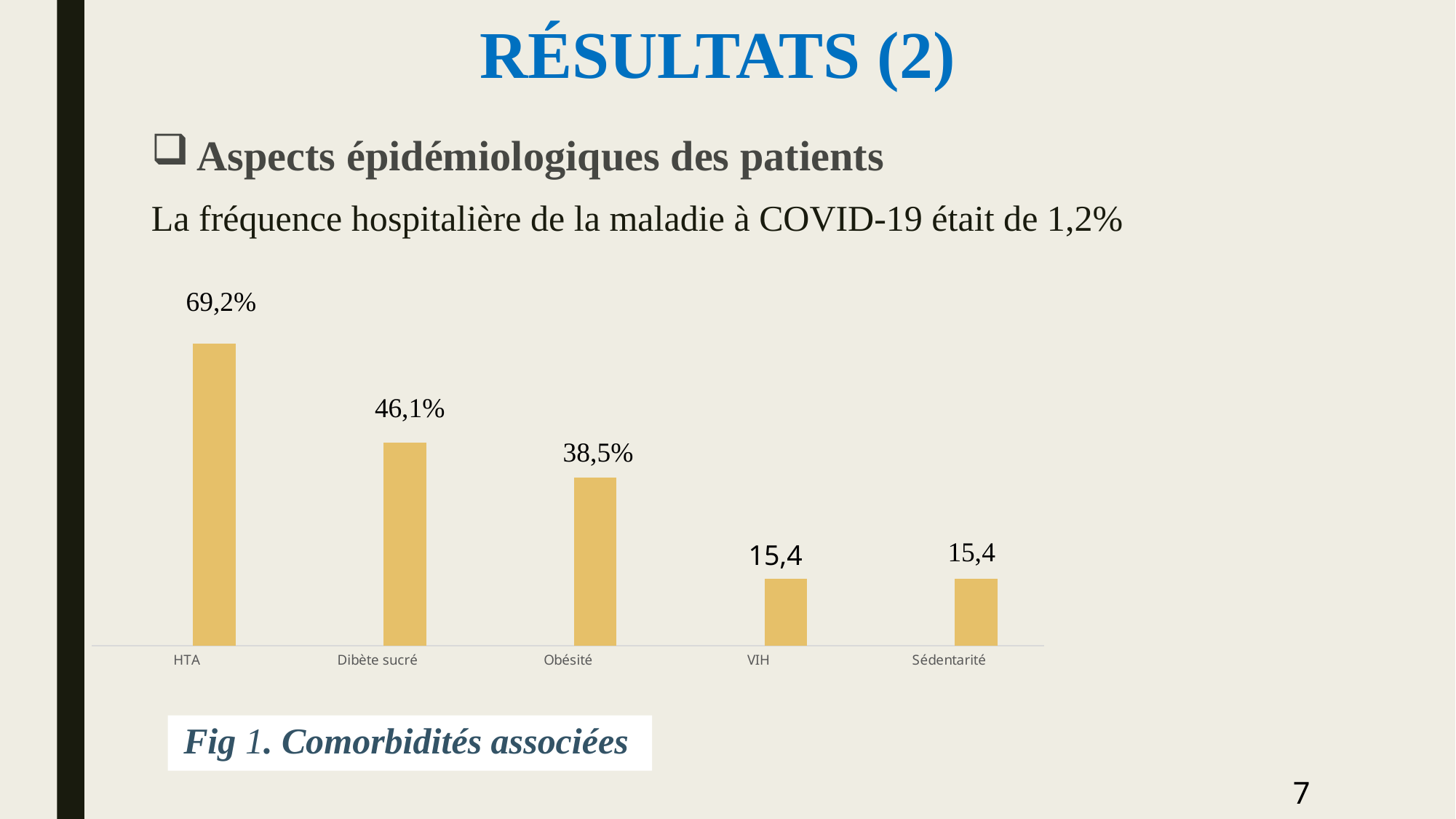
What is the difference between the values for Dibète sucré and Obésité? 7,6% What is the value shown for Sédentarité? 15,4 Which category has the highest value? HTA What is the value shown for VIH? 15,4 What is the value shown for Obésité? 38,5% What is the value shown for HTA? 69,2% What is the value shown for Dibète sucré? 46,1% How many categories are shown in the chart? 5 What kind of chart is shown on the slide? Bar chart Which two categories share the lowest value? VIH and Sédentarité Which is larger, the value for Obésité or the value for VIH? Obésité What is the difference between the values for HTA and Dibète sucré? 23,1%